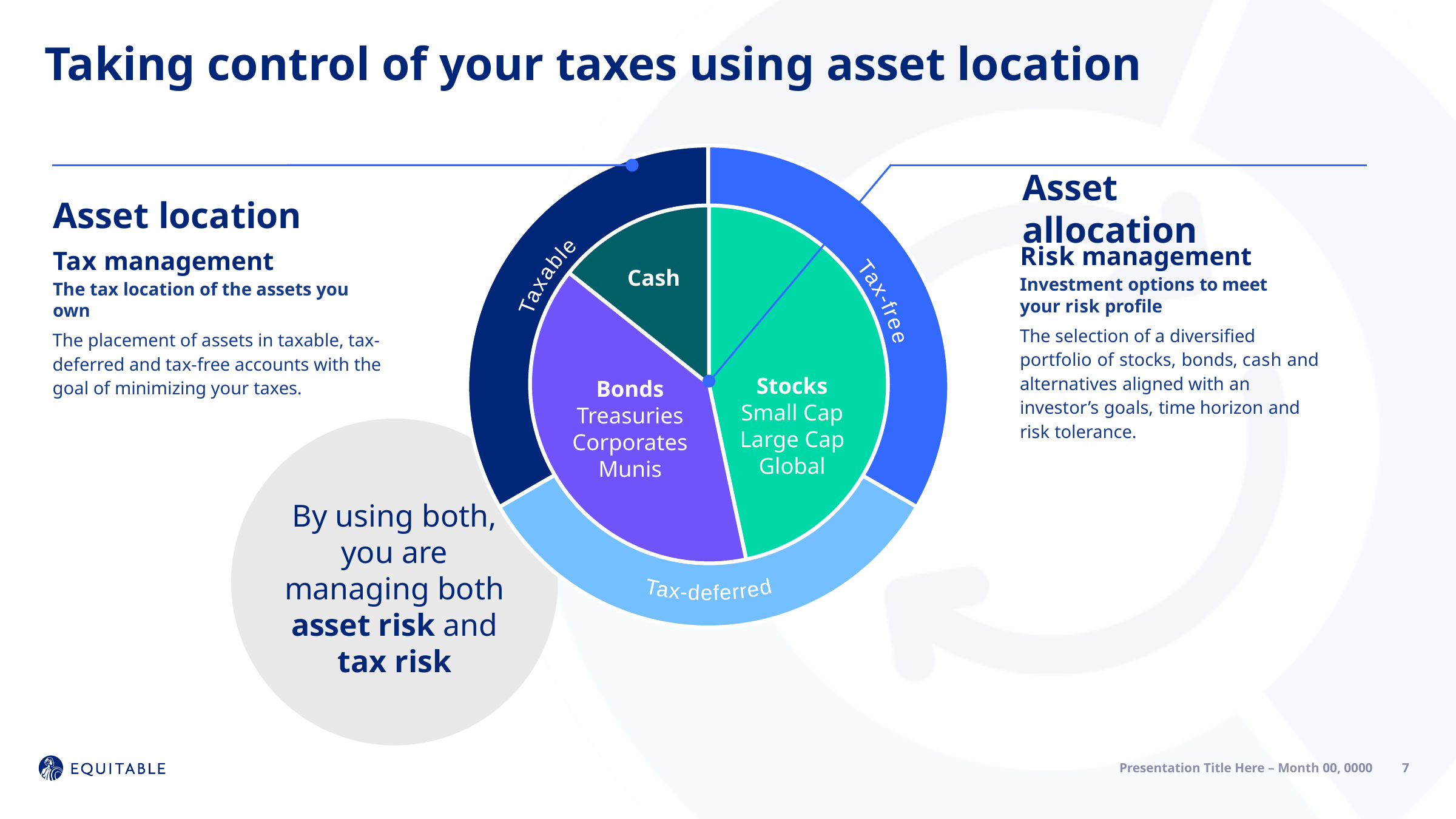
Which slice is larger in the inner pie chart, Bonds or Cash? Bonds What are the three labels on the outer ring of the chart? Taxable, Tax-free, Tax-deferred How many asset categories are shown in the inner pie chart? 3 Which asset category occupies the smallest slice of the inner pie chart? Cash How many segments make up the outer ring of the chart? 3 Which asset category occupies the largest slice of the inner pie chart? Stocks What kind of chart is shown in the centre of the slide? pie chart Which sub-categories are listed inside the Bonds slice? Treasuries, Corporates, Munis Which slice is larger in the inner pie chart, Stocks or Cash? Stocks